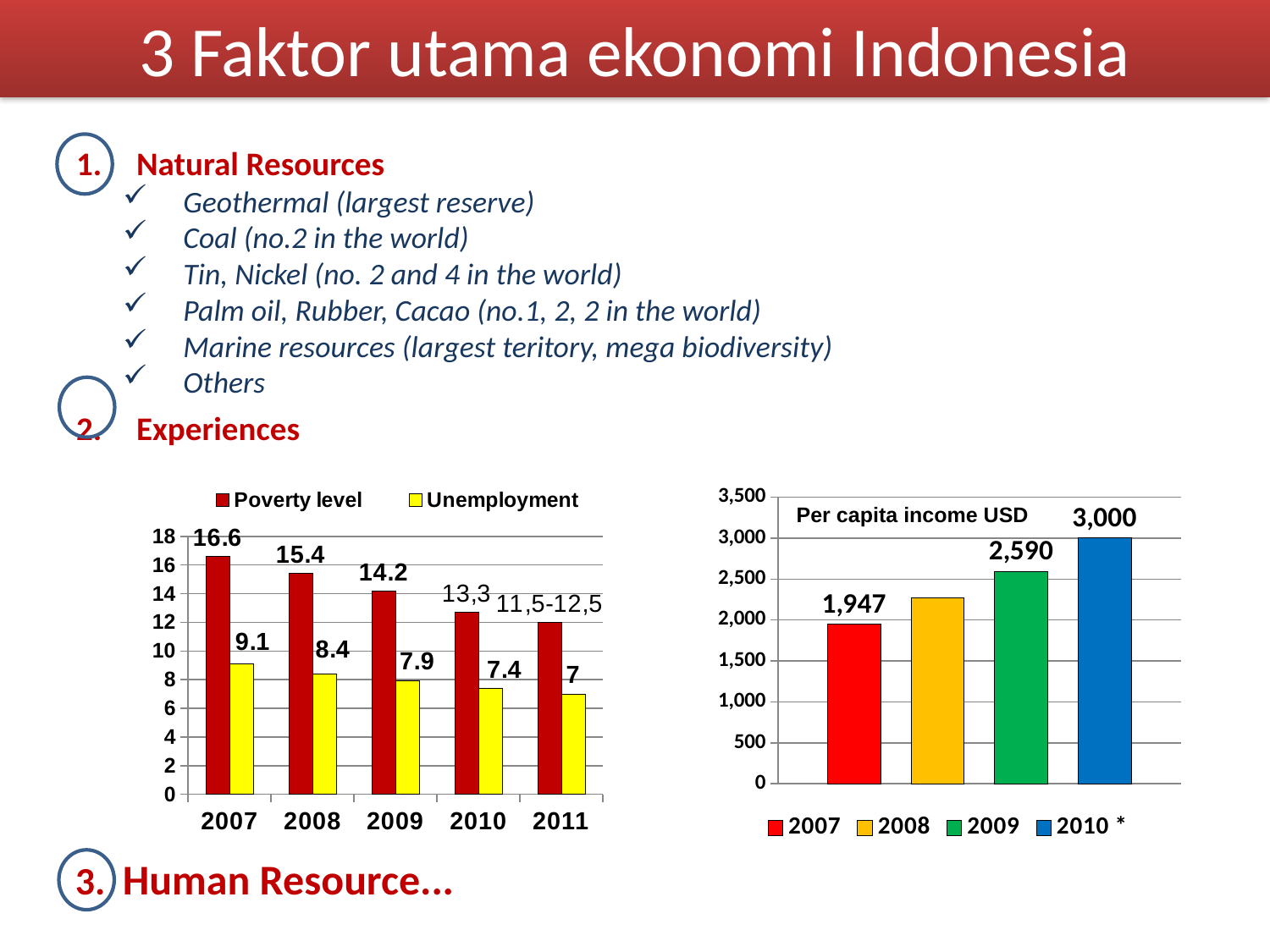
In the right chart (Per capita income USD), what is the value for 2009? 2,590 In the right chart (Per capita income USD), what is the difference between the 2010 value and the 2007 value? 1,053 In the left chart (Poverty level and Unemployment), what is the Unemployment value for 2009? 7.9 How many years are shown on the x axis of the left chart (Poverty level and Unemployment)? 5 In the left chart (Poverty level and Unemployment), what is the difference between the Poverty level in 2007 and in 2008? 1.2 How many series does the legend of the left chart (Poverty level and Unemployment) list? 2 What kind of chart is the left chart showing Poverty level and Unemployment? bar chart In the left chart (Poverty level and Unemployment), does the Unemployment series rise or fall from 2007 to 2011? fall In the left chart (Poverty level and Unemployment), what is the Poverty level value for 2007? 16.6 In the right chart (Per capita income USD), is the value for 2008 greater or less than 2,000? greater In the right chart (Per capita income USD), which year has the highest value? 2010 In the left chart (Poverty level and Unemployment), which is larger in 2008: the Poverty level or the Unemployment value? Poverty level